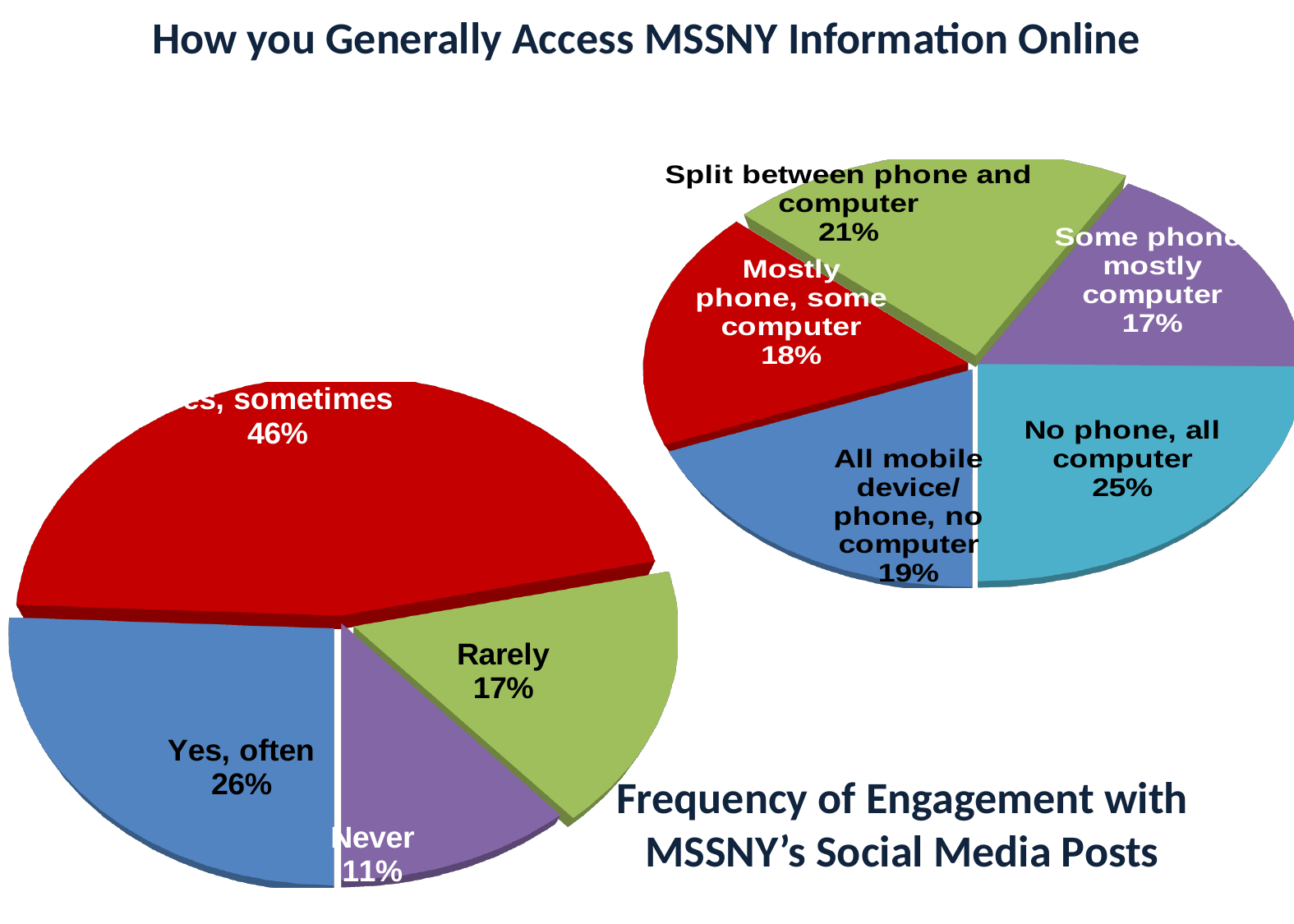
What type of chart is used for 'Frequency of Engagement with MSSNY's Social Media Posts'? Pie chart In the 'Frequency of Engagement with MSSNY's Social Media Posts' chart, which category has the smallest share? Never In the 'Frequency of Engagement with MSSNY's Social Media Posts' chart, what percentage is 'Yes, often'? 26% In the 'Frequency of Engagement with MSSNY's Social Media Posts' chart, which category has the largest share? Yes, sometimes In the 'How you Generally Access MSSNY Information Online' chart, what percentage is 'No phone, all computer'? 25% In the 'How you Generally Access MSSNY Information Online' chart, what percentage is 'Split between phone and computer'? 21% In the 'How you Generally Access MSSNY Information Online' chart, what is the difference between 'No phone, all computer' and 'All mobile device/phone, no computer'? 6% In the 'Frequency of Engagement with MSSNY's Social Media Posts' chart, which is larger, 'Yes, often' or 'Rarely'? Yes, often In the 'How you Generally Access MSSNY Information Online' chart, which category has the largest share? No phone, all computer In the 'How you Generally Access MSSNY Information Online' chart, which category has the smallest share? Some phone, mostly computer In the 'Frequency of Engagement with MSSNY's Social Media Posts' chart, what is the difference between 'Yes, sometimes' and 'Rarely'? 29% In the 'How you Generally Access MSSNY Information Online' chart, how many slices does the pie have? 5